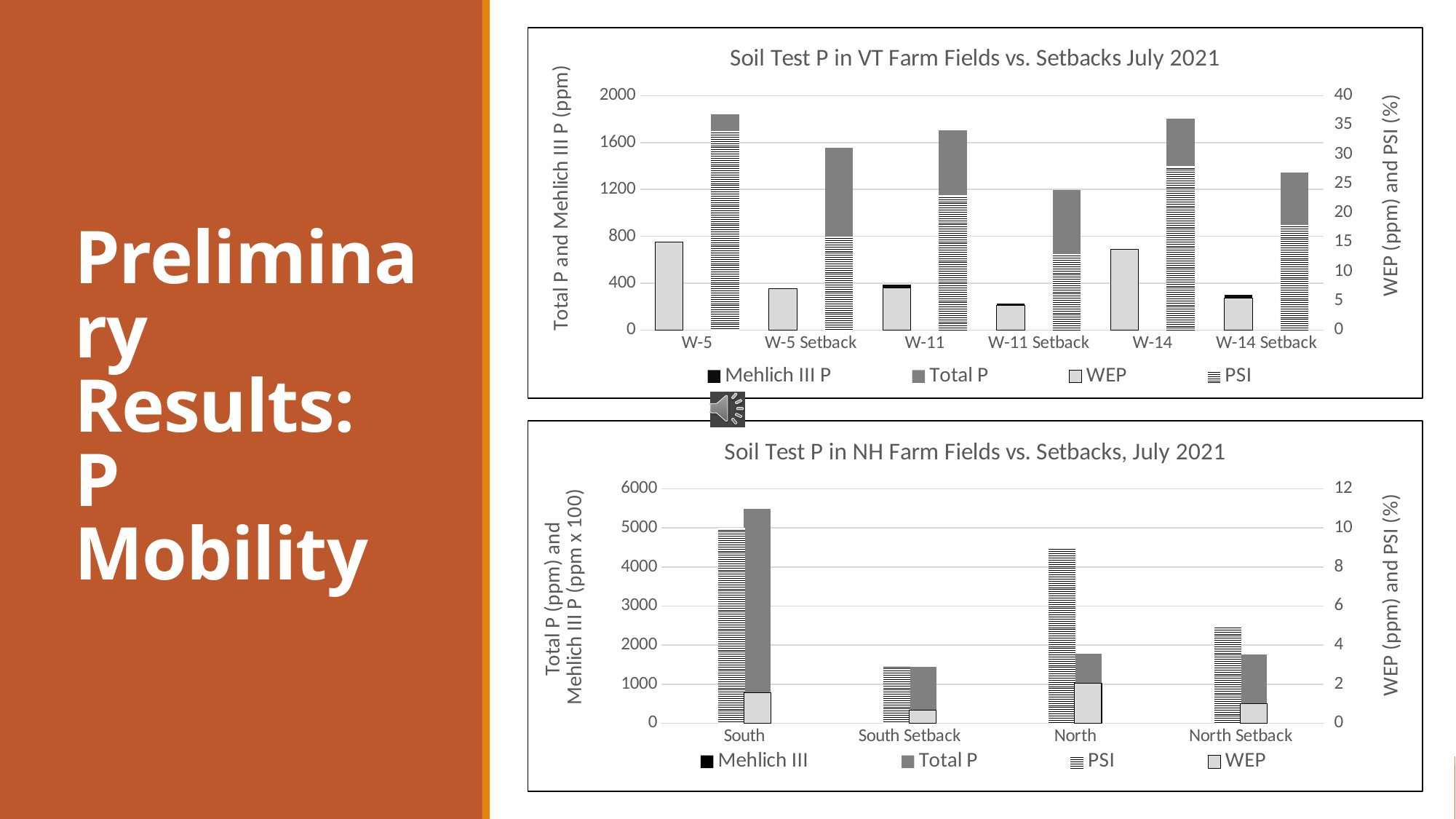
In the bottom chart, 'Soil Test P in NH Farm Fields vs. Setbacks, July 2021', which category has the highest top of the Total P stacked bar? South In the top chart, 'Soil Test P in VT Farm Fields vs. Setbacks July 2021', is the top of the Total P stacked bar for W-5 Setback greater or less than 1200? greater What is the title of the bottom chart on the slide? Soil Test P in NH Farm Fields vs. Setbacks, July 2021 In the top chart, 'Soil Test P in VT Farm Fields vs. Setbacks July 2021', which category has the lowest top of the Total P stacked bar? W-11 Setback In the bottom chart, 'Soil Test P in NH Farm Fields vs. Setbacks, July 2021', is the top of the Total P stacked bar for South greater or less than 5000? greater What type of chart is the top chart, 'Soil Test P in VT Farm Fields vs. Setbacks July 2021'? bar chart How many categories are shown on the x axis of the top chart, 'Soil Test P in VT Farm Fields vs. Setbacks July 2021'? 6 In the top chart, 'Soil Test P in VT Farm Fields vs. Setbacks July 2021', is the top of the Total P stacked bar for W-11 Setback greater or less than 1600? less How many series does the legend of the top chart, 'Soil Test P in VT Farm Fields vs. Setbacks July 2021', list? 4 How many categories are shown on the x axis of the bottom chart, 'Soil Test P in NH Farm Fields vs. Setbacks, July 2021'? 4 In the bottom chart, 'Soil Test P in NH Farm Fields vs. Setbacks, July 2021', which has the taller PSI bar, South or South Setback? South In the top chart, 'Soil Test P in VT Farm Fields vs. Setbacks July 2021', which has the taller Total P stacked bar, W-11 or W-11 Setback? W-11